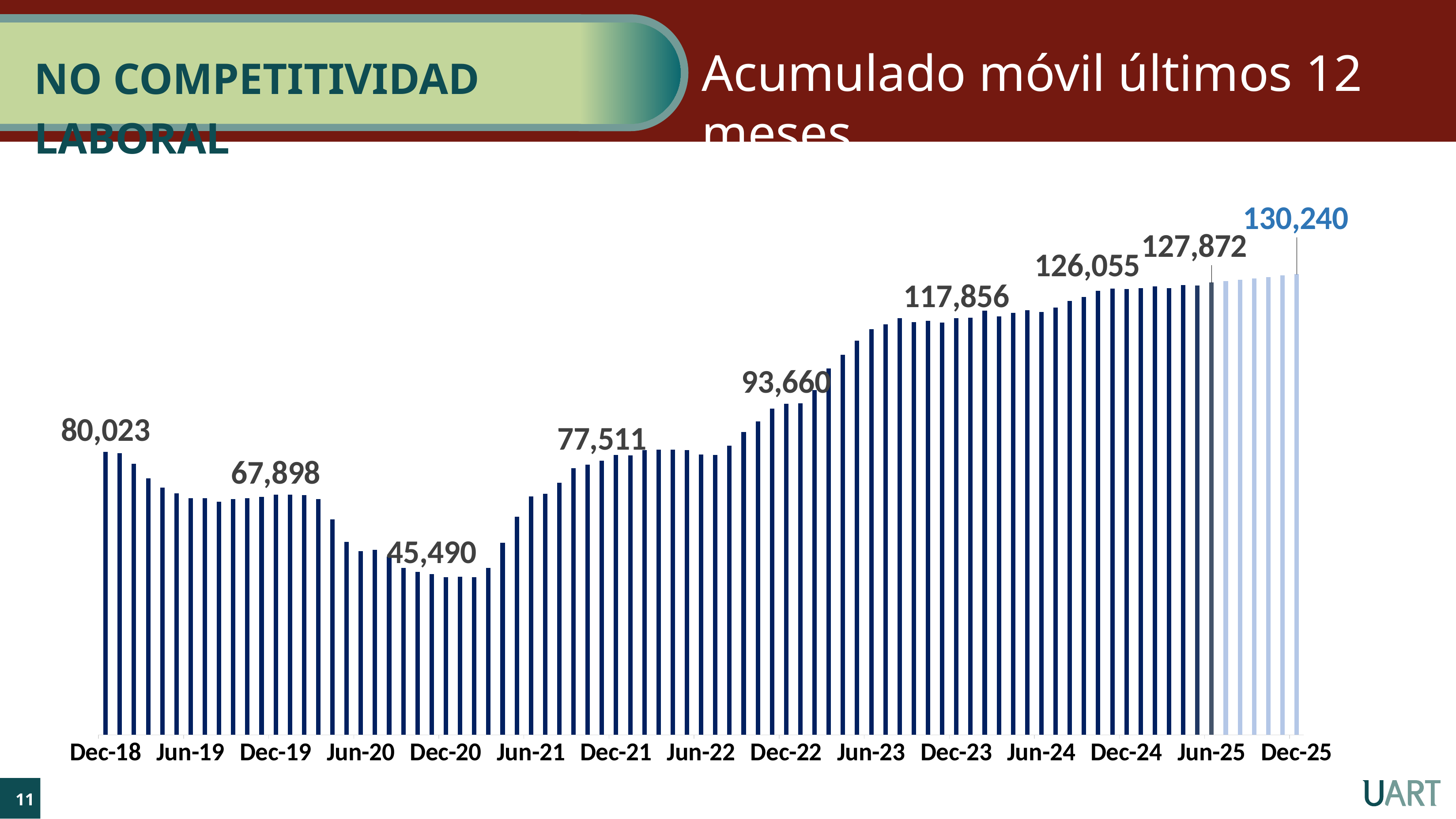
What is the difference between the Dec-23 value (117,856) and the Dec-22 value (93,660)? 24,196 What is the value labelled for Dec-18? 80,023 What kind of chart is shown on the slide? Bar chart What is the value labelled for Dec-20? 45,490 What is the difference between the Dec-25 value (130,240) and the Jun-25 value (127,872)? 2,368 Which labelled point has the highest value? Dec-25 Do the values rise or fall from Dec-20 to Dec-25? Rise What is the title of the chart shown on the slide? Acumulado móvil últimos 12 meses Which is larger, the value for Dec-19 or the value for Dec-21? Dec-21 Which labelled point has the lowest value? Dec-20 What is the value labelled for Dec-24? 126,055 What is the value labelled for Dec-25? 130,240